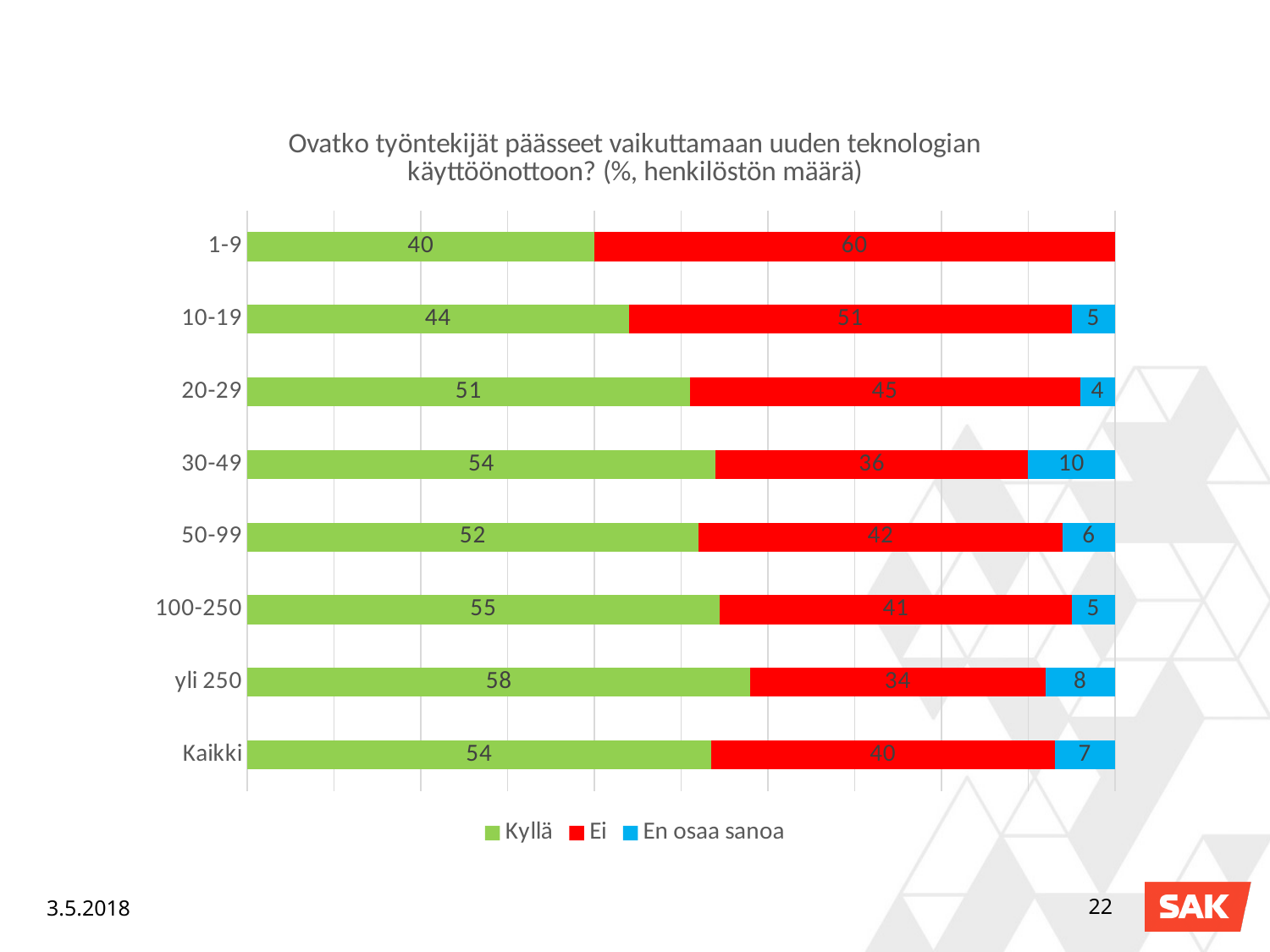
What kind of chart is shown on the slide? stacked bar chart What is the Ei value for the 30-49 category? 36 Which category has the lowest Kyllä value? 1-9 How many series does the legend list? 3 What is the En osaa sanoa value for the yli 250 category? 8 What is the difference between the Ei values for 1-9 and yli 250? 26 What is the total of the stacked bar for the 30-49 category? 100 Which is larger, the Kyllä value for 100-250 or the Kyllä value for 50-99? 100-250 Which category has the highest En osaa sanoa value? 30-49 How many categories are shown on the y axis? 8 Which category has the highest Kyllä value? yli 250 What is the Kyllä value for the 1-9 category? 40